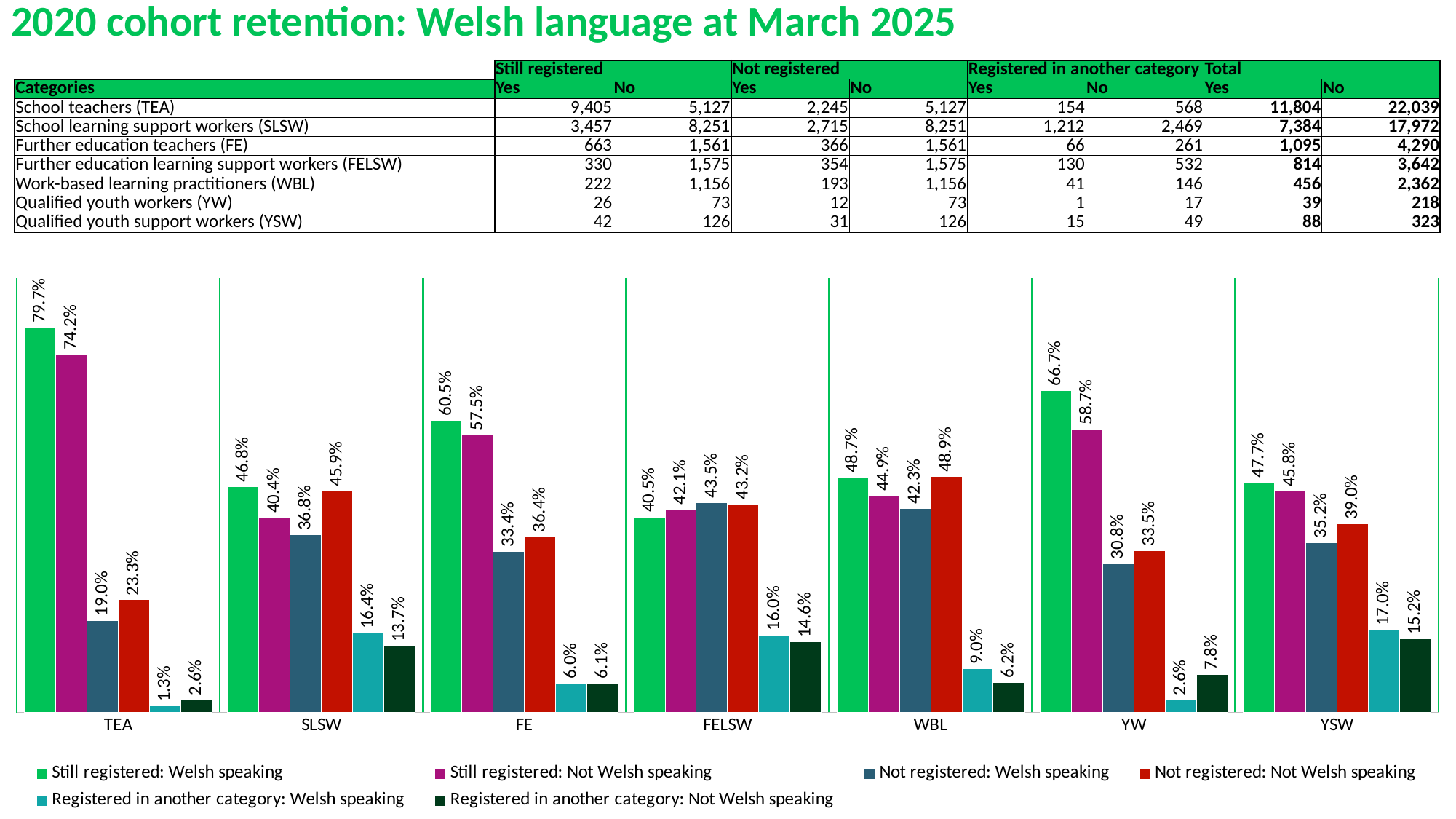
Which category has the lowest value for 'Registered in another category: Welsh speaking'? TEA What is the value for 'Still registered: Welsh speaking' for TEA? 79.7% What colour represents 'Still registered: Welsh speaking' in the chart? Green For YSW, what is the difference between 'Not registered: Not Welsh speaking' and 'Not registered: Welsh speaking'? 3.8 percentage points What kind of chart is shown on the slide? Bar chart How many series does the chart legend list? 6 How many categories are shown on the x axis of the chart? 7 What is the value for 'Not registered: Not Welsh speaking' for WBL? 48.9% For FELSW, which is larger: 'Not registered: Welsh speaking' or 'Still registered: Welsh speaking'? Not registered: Welsh speaking Which category has the highest value for 'Still registered: Welsh speaking'? TEA For TEA, what is the difference between 'Still registered: Welsh speaking' and 'Still registered: Not Welsh speaking'? 5.5 percentage points What is the value for 'Registered in another category: Not Welsh speaking' for YW? 7.8%